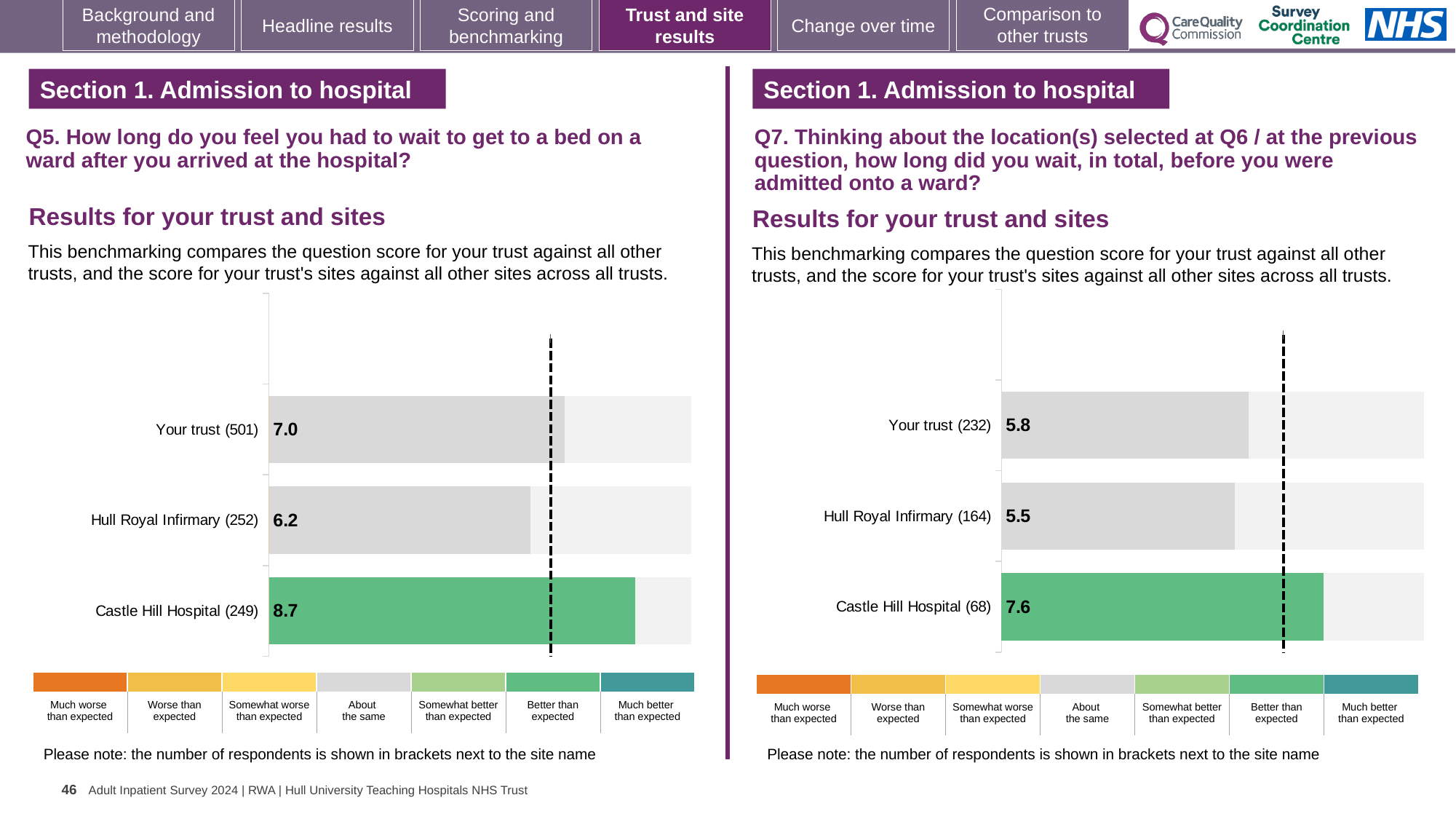
In the Q7 chart on the right, which site or trust has the highest score? Castle Hill Hospital In the Q5 chart on the left, what is the score for Castle Hill Hospital? 8.7 In the Q7 chart on the right, what is the difference between the scores for Castle Hill Hospital and Your trust? 1.8 In the Q7 chart on the right, is the score for Your trust larger or smaller than the score for Hull Royal Infirmary? larger In the Q5 chart on the left, what is the difference between the scores for Castle Hill Hospital and Hull Royal Infirmary? 2.5 How many bars are plotted in the Q5 chart on the left? 3 What type of chart is used in the Q7 chart on the right? Bar chart In the Q5 chart on the left, how many respondents are shown for Castle Hill Hospital? 249 In the Q7 chart on the right, how many respondents are shown for Your trust? 232 In the Q5 chart on the left, what is the score for Your trust? 7.0 In the Q7 chart on the right, what is the score for Hull Royal Infirmary? 5.5 In the Q5 chart on the left, which site or trust has the lowest score? Hull Royal Infirmary